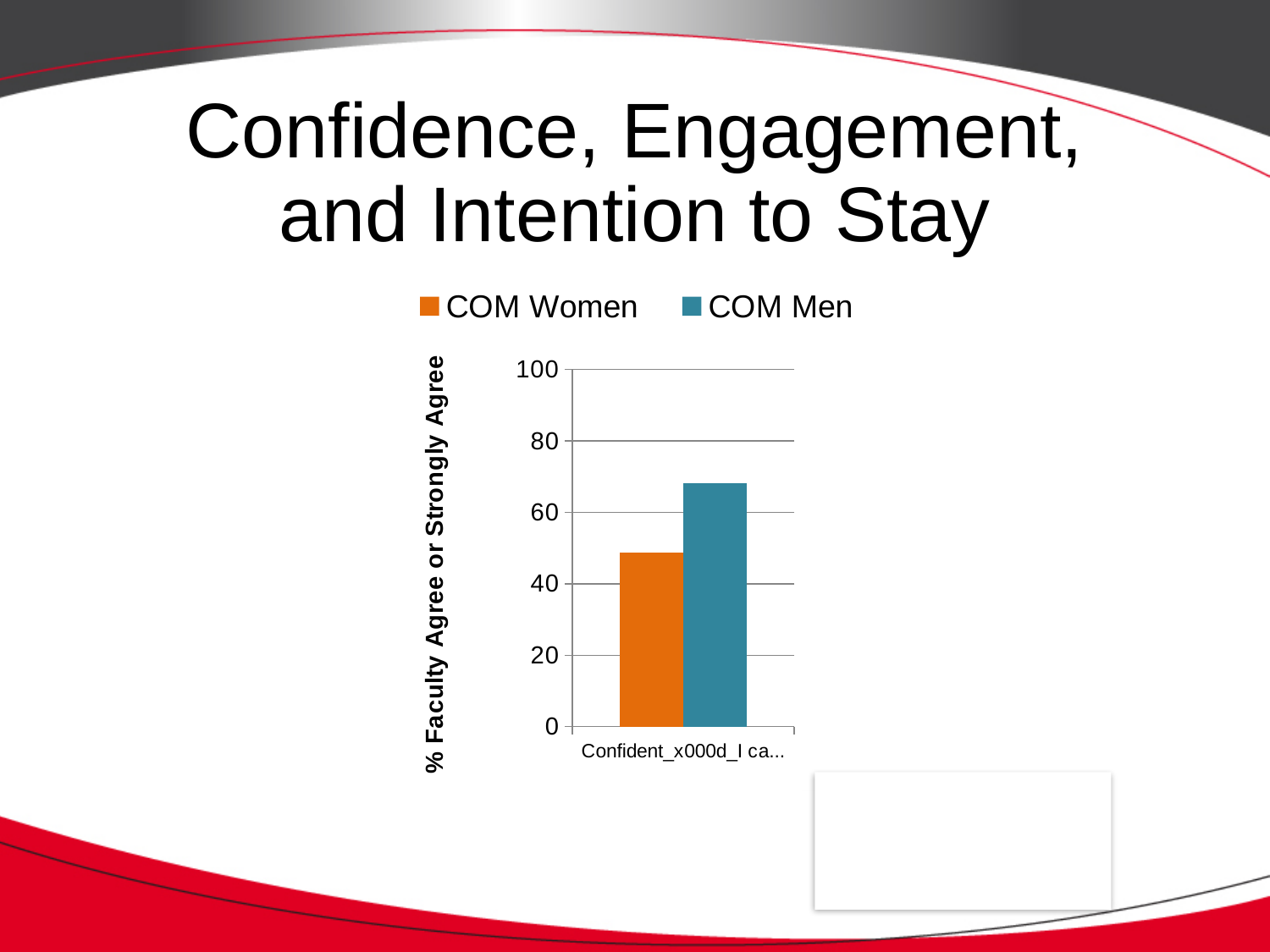
How many series does the chart legend list? 2 Which series has the lowest bar in the chart? COM Women Which colour represents COM Women in the chart legend? orange Is the value for COM Women greater or less than 60? less Which series has the taller bar, COM Women or COM Men? COM Men How many categories are plotted on the x axis of the chart? 1 What kind of chart is shown on the slide? bar chart What is the title of the vertical axis of the chart? % Faculty Agree or Strongly Agree Is the value for COM Men greater or less than 80? less Which series has the highest bar in the chart? COM Men Is the value for COM Women greater or less than 40? greater